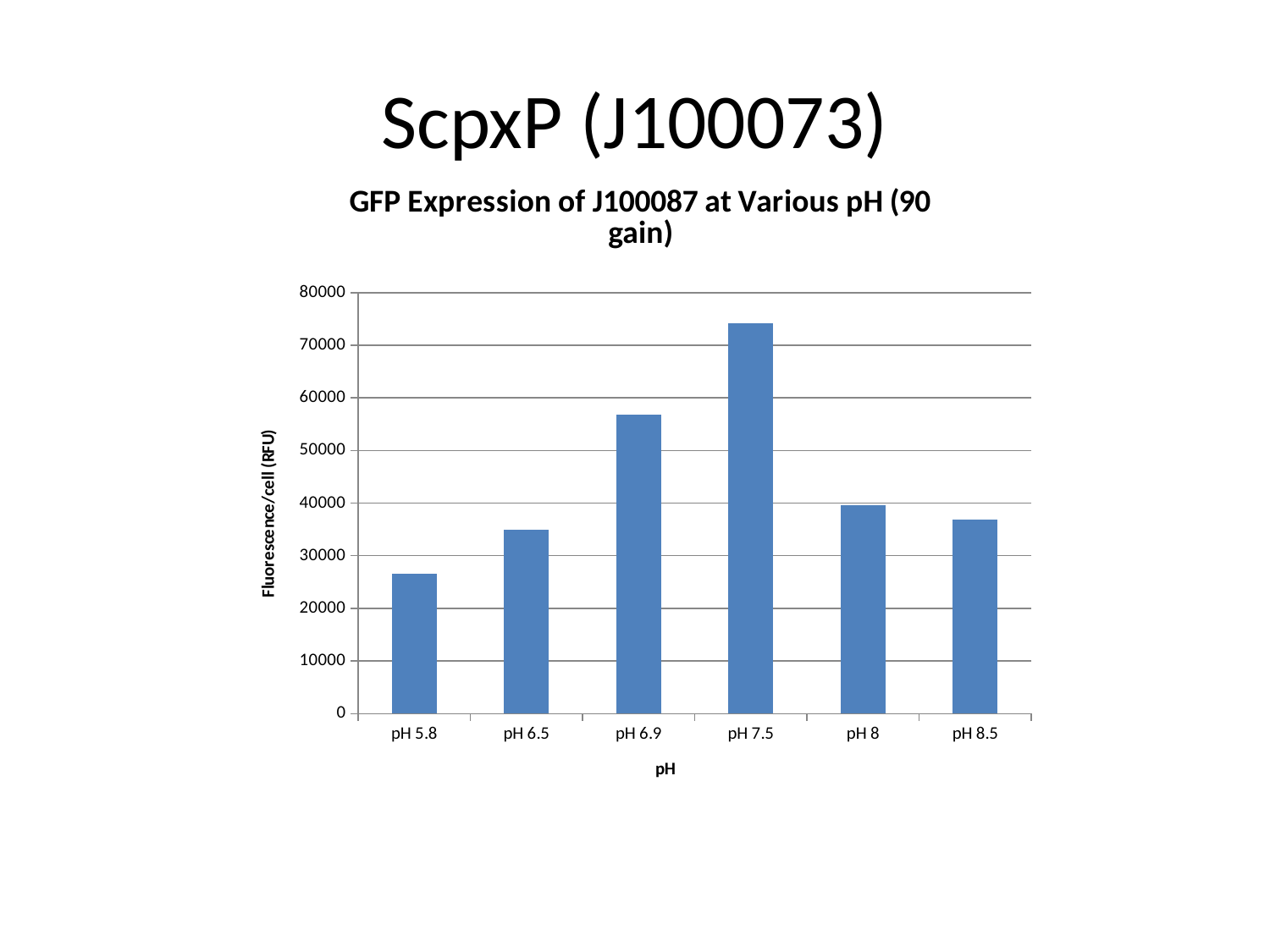
Is the value for pH 7.5 greater or less than 70000? greater What is the label of the vertical axis? Fluorescence/cell (RFU) Is the value for pH 5.8 greater or less than 30000? less Is the value for pH 6.9 greater or less than 50000? greater Which has the higher fluorescence per cell, pH 6.9 or pH 8? pH 6.9 What kind of chart is shown on the slide? bar chart Which has the higher fluorescence per cell, pH 5.8 or pH 6.5? pH 6.5 How many pH categories are plotted on the chart? 6 Which pH has the highest fluorescence per cell? pH 7.5 What is the title of the chart? GFP Expression of J100087 at Various pH (90 gain) Which pH has the lowest fluorescence per cell? pH 5.8